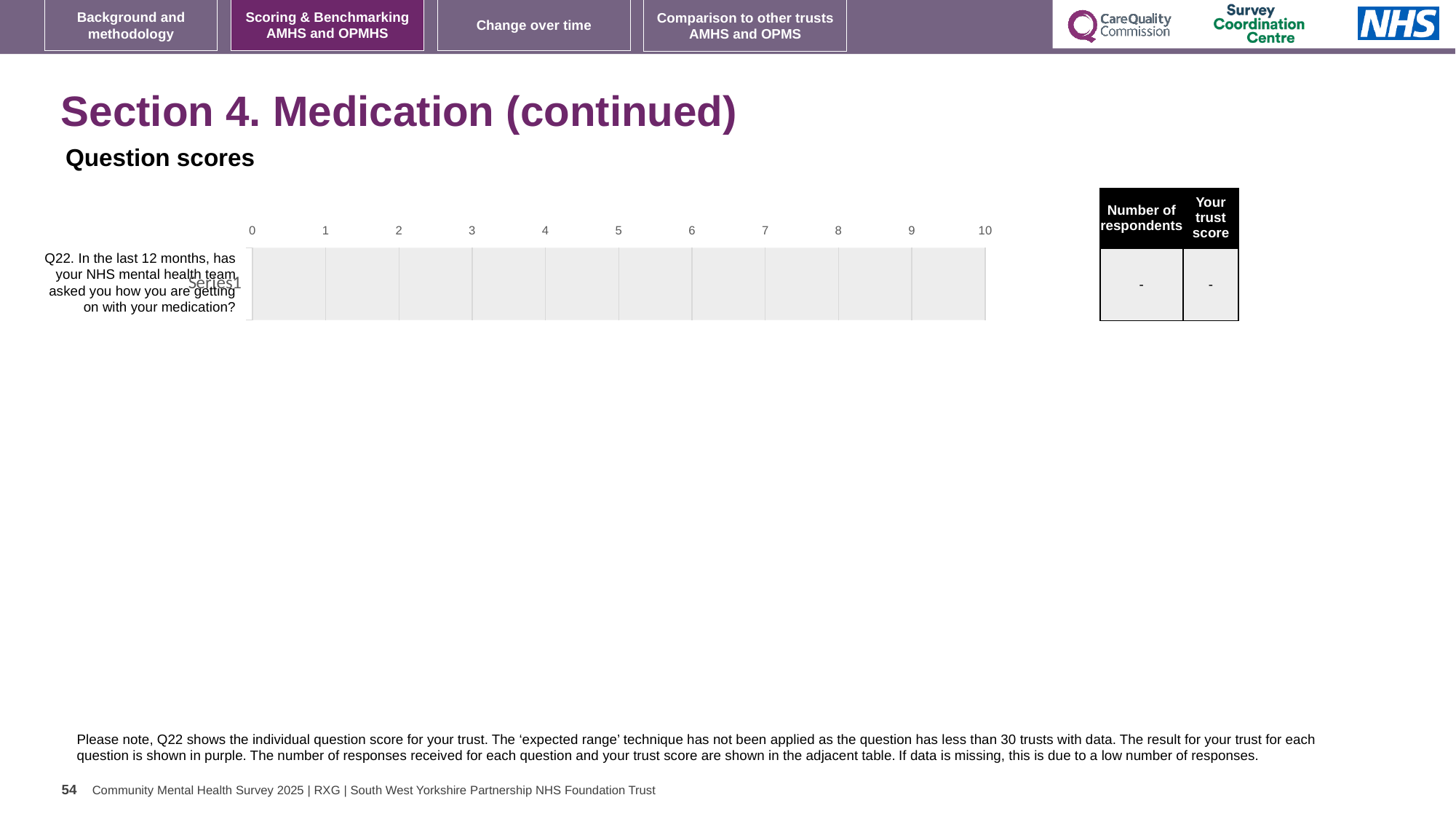
How many question categories are listed on the chart's vertical axis? 1 What is shown in the 'Your trust score' column of the table for Q22? - What is the highest value shown on the chart's horizontal axis? 10 What kind of chart is shown on the slide? Bar chart What is shown in the 'Number of respondents' column of the table for Q22? - Which question is shown as the category on the chart? Q22. In the last 12 months, has your NHS mental health team asked you how you are getting on with your medication? Is a bar plotted for Q22 on the chart? No